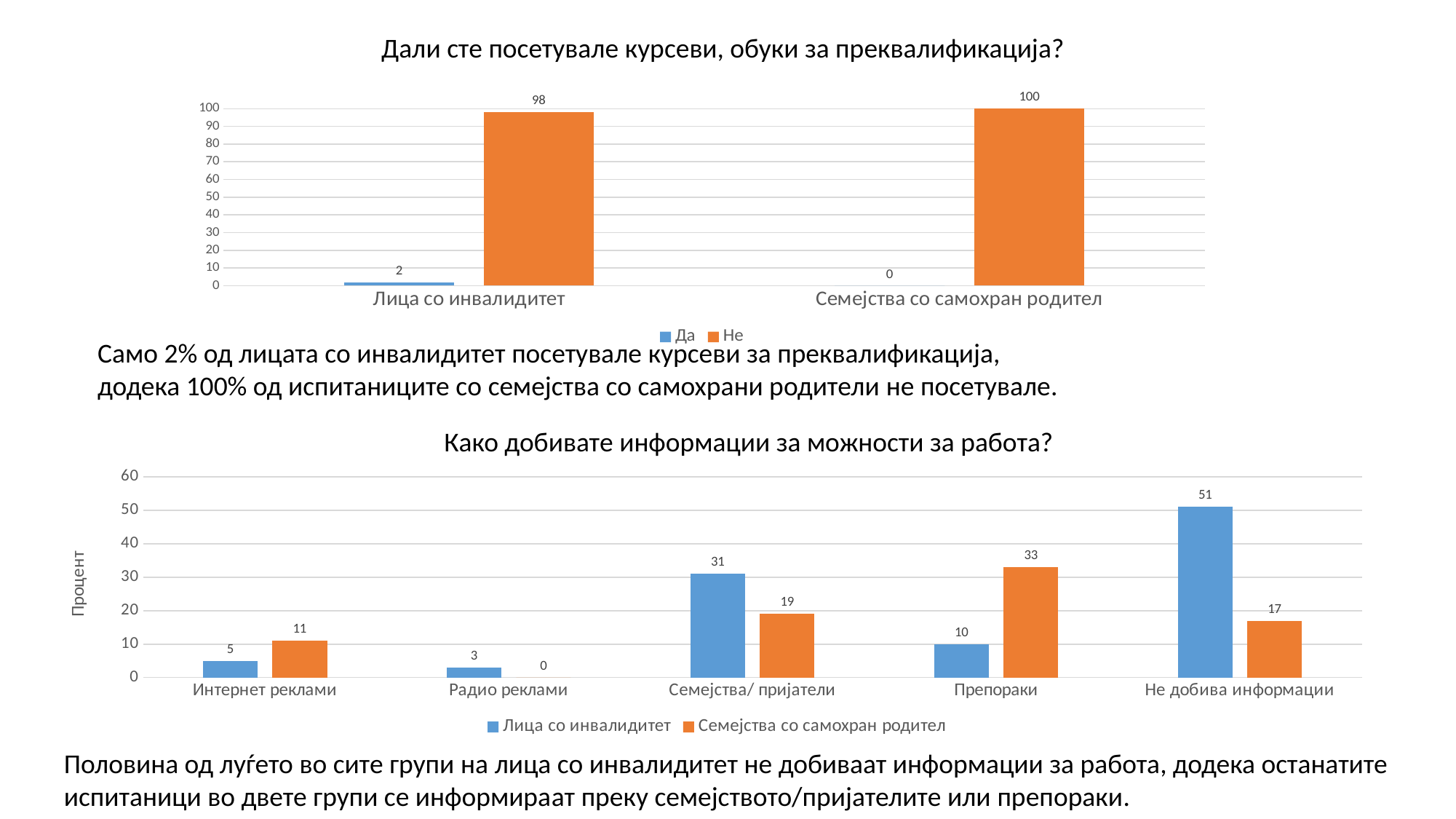
In the chart titled "Како добивате информации за можности за работа?", what is the value for "Семејства со самохран родител" in the "Препораки" category? 33 In the chart titled "Дали сте посетувале курсеви, обуки за преквалификација?", what is the difference between "Не" and "Да" for "Лица со инвалидитет"? 96 In the chart titled "Како добивате информации за можности за работа?", which series has the larger value in the "Интернет реклами" category? Семејства со самохран родител In the chart titled "Дали сте посетувале курсеви, обуки за преквалификација?", what is the value of "Не" for "Лица со инвалидитет"? 98 In the chart titled "Како добивате информации за можности за работа?", which category has the highest value for "Лица со инвалидитет"? Не добива информации In the chart titled "Дали сте посетувале курсеви, обуки за преквалификација?", how many series does the legend list? 2 In the chart titled "Како добивате информации за можности за работа?", what is the value for "Лица со инвалидитет" in the "Не добива информации" category? 51 What kind of chart is the one titled "Како добивате информации за можности за работа?"? Bar chart In the chart titled "Како добивате информации за можности за работа?", what is the difference between "Лица со инвалидитет" and "Семејства со самохран родител" in the "Семејства/ пријатели" category? 12 In the chart titled "Како добивате информации за можности за работа?", which category has the lowest value for "Семејства со самохран родител"? Радио реклами In the chart titled "Дали сте посетувале курсеви, обуки за преквалификација?", what is the value of "Да" for "Семејства со самохран родител"? 0 In the chart titled "Како добивате информации за можности за работа?", how many categories are shown on the x axis? 5